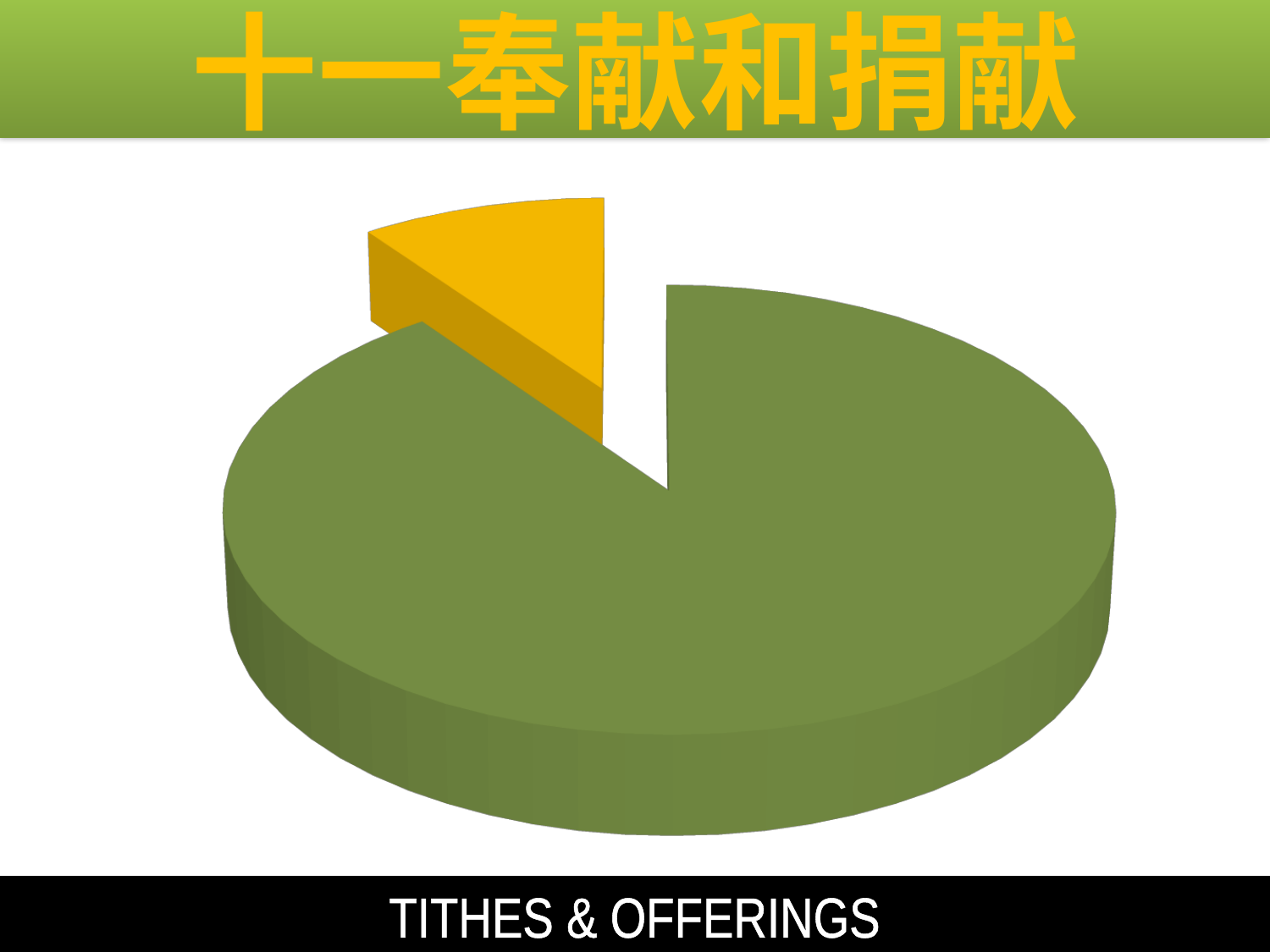
Which slice is larger, the green slice or the yellow slice? green Which colour slice is the largest in the pie chart? green Which colour slice is the smallest in the pie chart? yellow Is the yellow slice more or less than half of the pie? less What English caption appears below the pie chart? TITHES & OFFERINGS How many slices does the pie chart have? 2 What is the Chinese title shown at the top of the slide? 十一奉献和捐献 What kind of chart is shown on the slide? pie chart